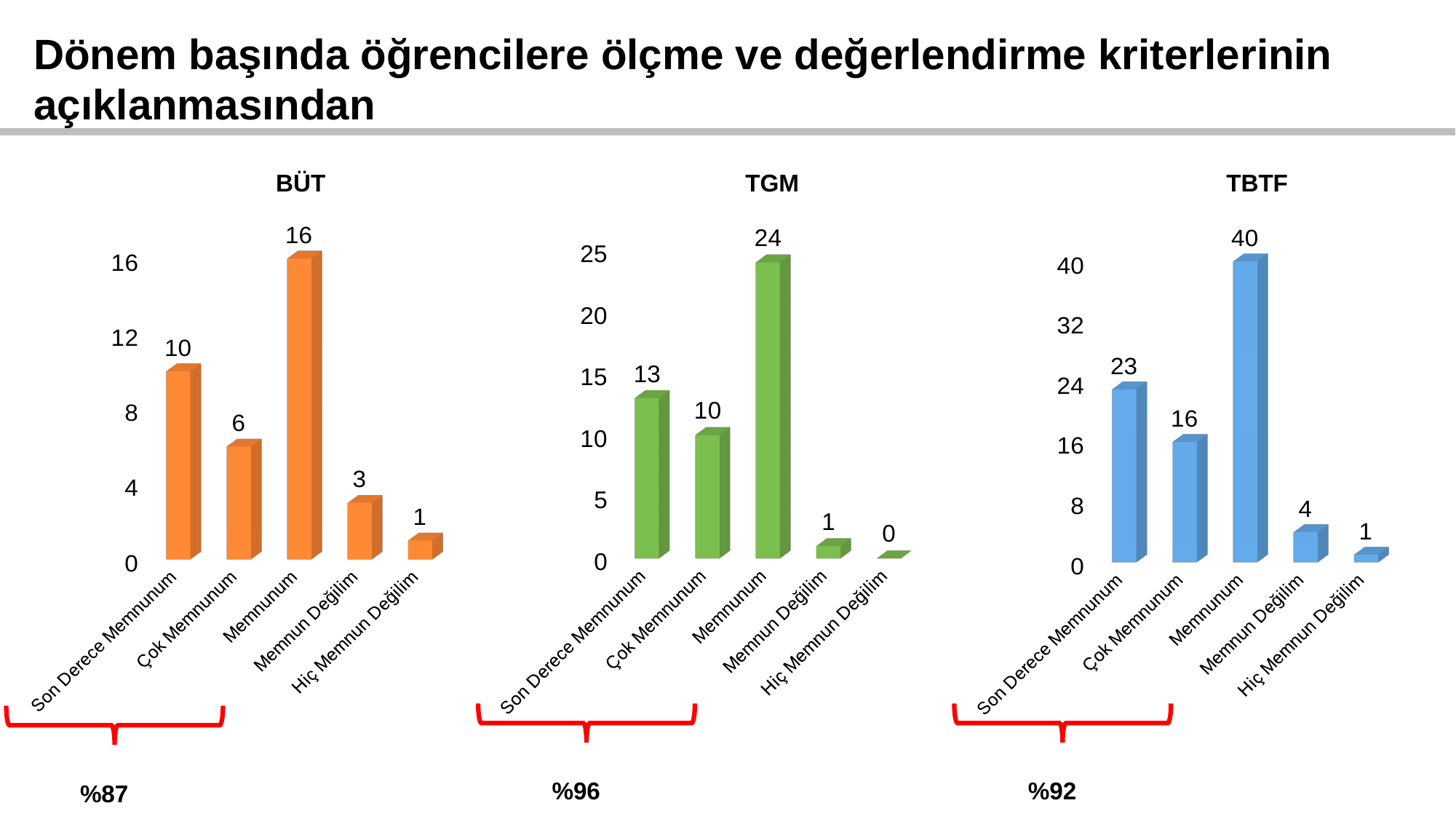
How many categories does the BÜT chart show? 5 In the TBTF chart, what is the value for Hiç Memmun Değilim? 1 In the BÜT chart, what is the difference between the values for Memnunum and Son Derece Memnunum? 6 In the TGM chart, which is larger: the value for Son Derece Memnunum or the value for Çok Memnunum? Son Derece Memnunum In the TBTF chart, what is the value for Memnun Değilim? 4 What colour are the bars in the TGM chart? green In the TBTF chart, which category has the highest value? Memnunum In the BÜT chart, what is the value for Memnunum? 16 What kind of chart is the TGM chart? bar chart In the TGM chart, which category has the lowest value? Hiç Memnun Değilim In the TBTF chart, what is the difference between the values for Son Derece Memnunum and Çok Memnunum? 7 In the TGM chart, what is the value for Son Derece Memnunum? 13